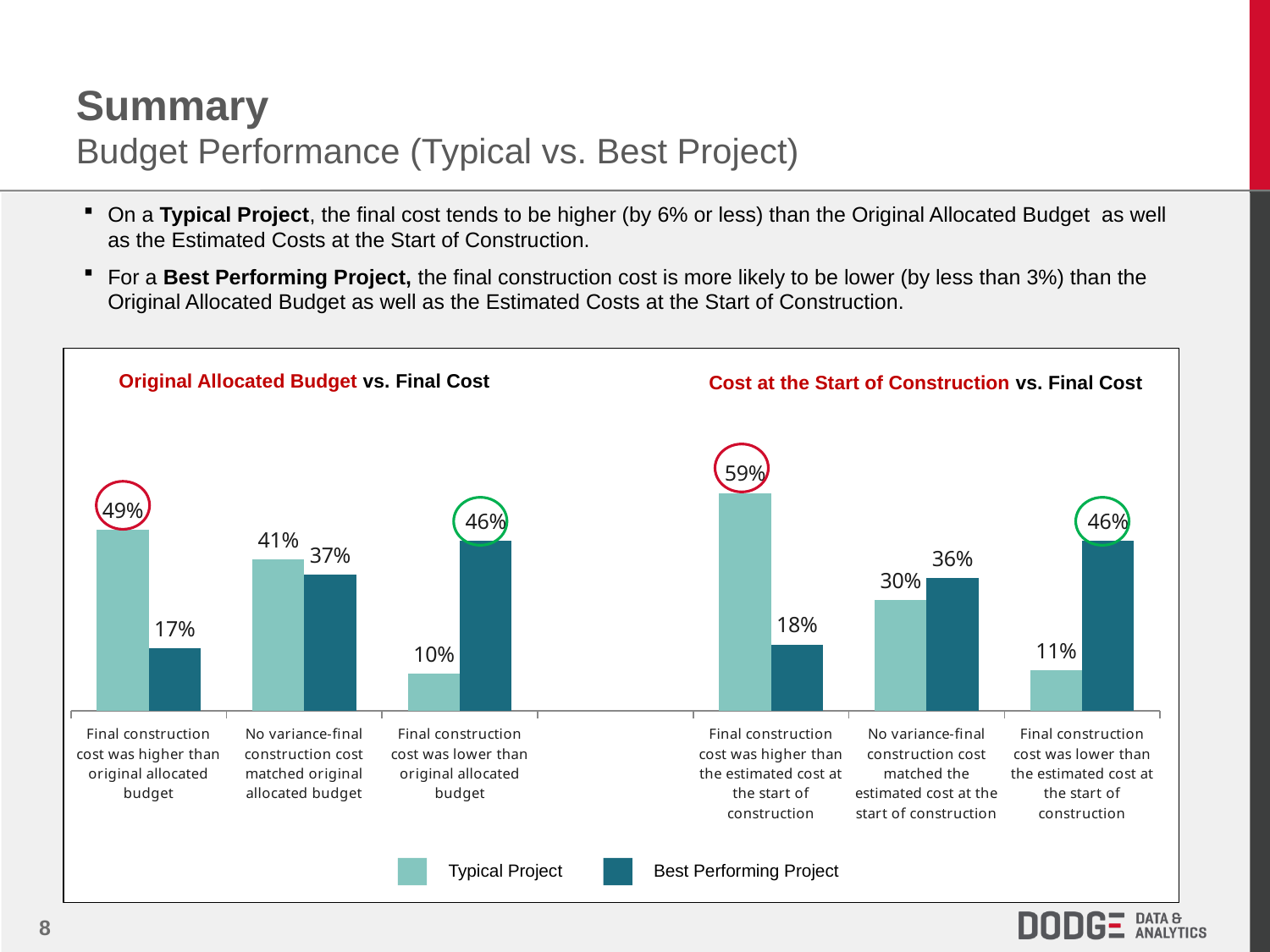
In the 'Cost at the Start of Construction vs. Final Cost' chart, what is the difference between the Typical Project and Best Performing Project values for 'Final construction cost was lower than the estimated cost at the start of construction'? 35 percentage points In the 'Cost at the Start of Construction vs. Final Cost' chart, what is the Typical Project value for 'Final construction cost was higher than the estimated cost at the start of construction'? 59% How many series does the legend list? 2 In the 'Original Allocated Budget vs. Final Cost' chart, what is the difference between the Typical Project and Best Performing Project values for 'Final construction cost was higher than original allocated budget'? 32 percentage points In the 'Original Allocated Budget vs. Final Cost' chart, what is the Best Performing Project value for 'Final construction cost was lower than original allocated budget'? 46% What kind of chart is used on this slide? Bar chart In the 'Original Allocated Budget vs. Final Cost' chart, which category has the lowest Typical Project value? Final construction cost was lower than original allocated budget In the 'Cost at the Start of Construction vs. Final Cost' chart, which category has the highest Best Performing Project value? Final construction cost was lower than the estimated cost at the start of construction In the 'Original Allocated Budget vs. Final Cost' chart, what percentage of Typical Projects had a final construction cost higher than the original allocated budget? 49% In the 'Cost at the Start of Construction vs. Final Cost' chart, what is the Best Performing Project value for 'No variance-final construction cost matched the estimated cost at the start of construction'? 36% In the 'Original Allocated Budget vs. Final Cost' chart, for 'No variance-final construction cost matched original allocated budget', which is larger: the Typical Project value or the Best Performing Project value? Typical Project How many categories are shown in the 'Cost at the Start of Construction vs. Final Cost' chart? 3